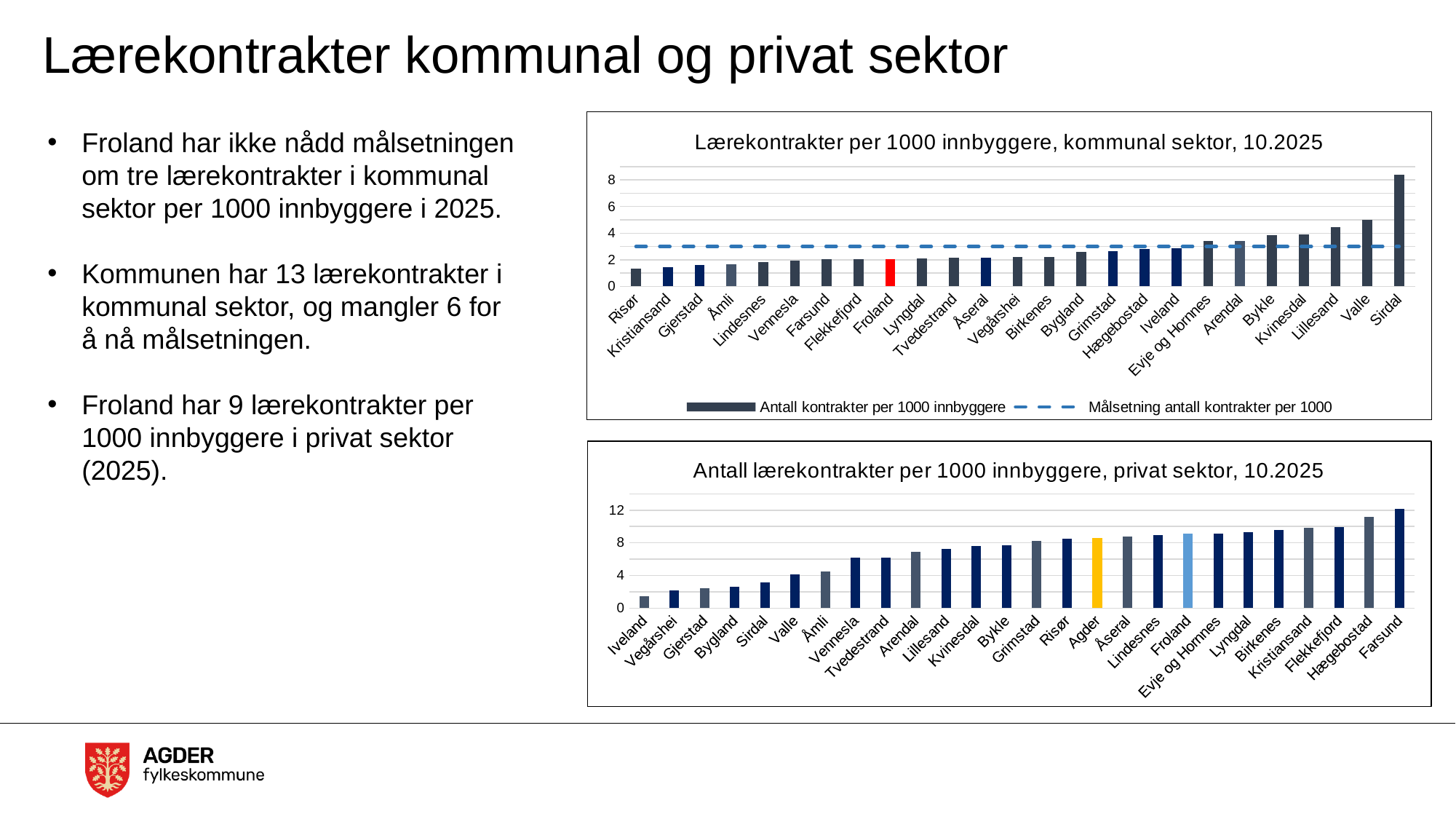
In the bottom chart (privat sektor), do the values rise or fall from left to right along the x axis? Rise In the bottom chart (privat sektor), which municipality has the lowest number of lærekontrakter per 1000 innbyggere? Iveland What kind of chart is the bottom chart (privat sektor)? Bar chart In the top chart (kommunal sektor), is the value for Sirdal greater or less than 8? greater In the top chart (kommunal sektor), which municipality has the lowest number of lærekontrakter per 1000 innbyggere? Risør In the bottom chart (privat sektor), which municipality has the highest number of lærekontrakter per 1000 innbyggere? Farsund How many series does the legend of the top chart (kommunal sektor) list? 2 In the bottom chart (privat sektor), is the value for Froland greater or less than 8? greater How many municipalities are shown on the x axis of the top chart (kommunal sektor)? 25 In the top chart (kommunal sektor), which municipality has the highest number of lærekontrakter per 1000 innbyggere? Sirdal In the top chart (kommunal sektor), is the value for Froland greater or less than 3? less In the top chart (kommunal sektor), which is larger, the value for Valle or the value for Lillesand? Valle